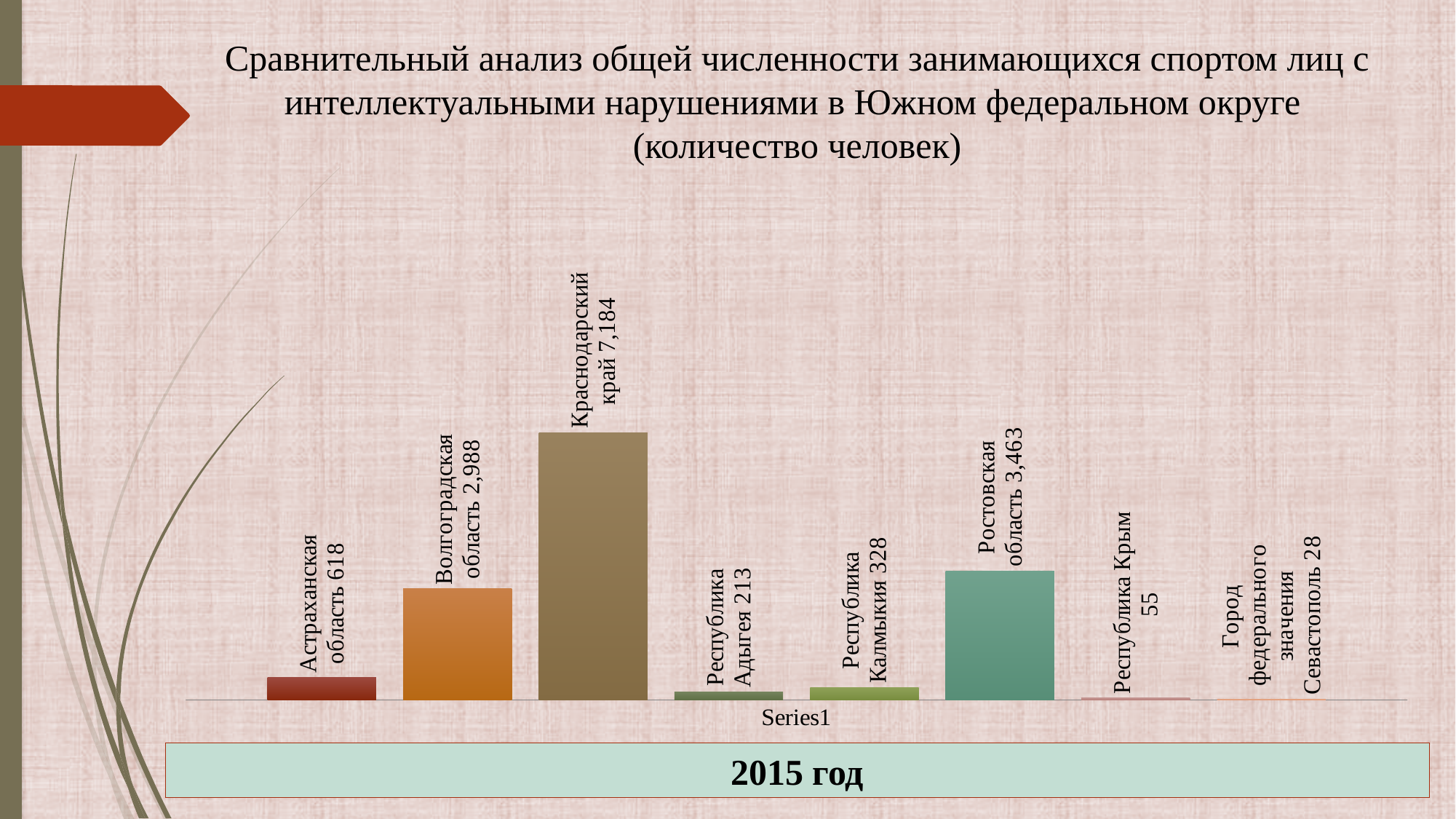
Which region has the lowest value? Город федерального значения Севастополь Which is larger, the value for Волгоградская область or the value for Ростовская область? Ростовская область What is the difference between the values for Астраханская область and Республика Адыгея? 405 Which region has the highest value? Краснодарский край What is the value for Ростовская область? 3,463 What is the value for Республика Калмыкия? 328 What year is indicated in the box below the chart? 2015 год What is the value for Краснодарский край? 7,184 What kind of chart is shown on the slide? Bar chart How many regions are shown in the chart? 8 What is the value for Город федерального значения Севастополь? 28 What is the difference between the values for Краснодарский край and Ростовская область? 3,721